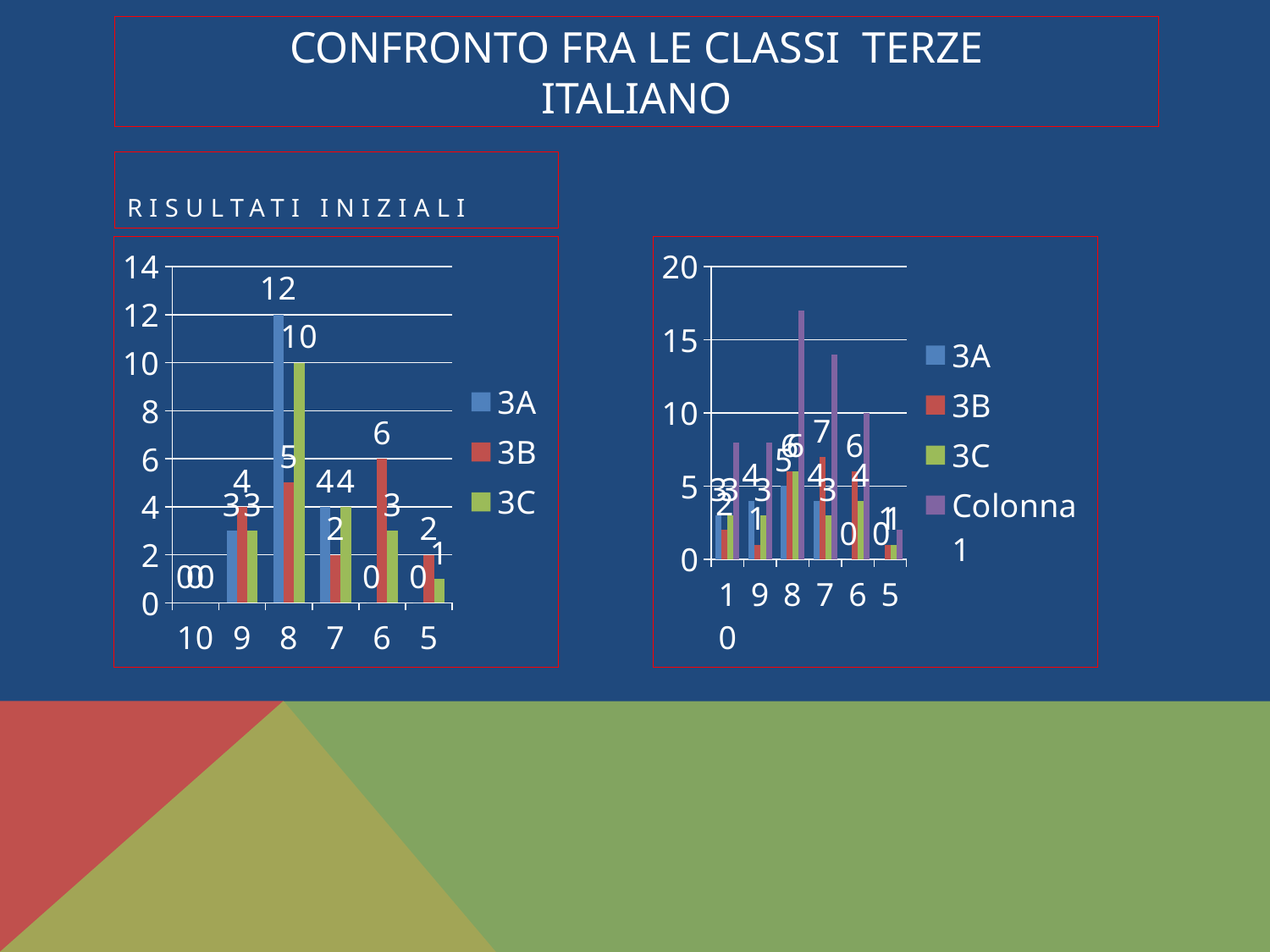
In the left chart (RISULTATI INIZIALI), how many categories are shown on the x axis? 6 In the left chart (RISULTATI INIZIALI), what is the value for 3C at category 8? 10 In the right chart, what is the fourth entry in the legend? Colonna 1 In the left chart (RISULTATI INIZIALI), at which category does 3A reach its highest value? 8 What kind of chart is the left chart (RISULTATI INIZIALI)? bar chart In the left chart (RISULTATI INIZIALI), what is the value for 3A at category 8? 12 In the left chart (RISULTATI INIZIALI), which is larger at category 6, 3B or 3C? 3B In the right chart, how many series does the legend list? 4 In the left chart (RISULTATI INIZIALI), how many series does the legend list? 3 In the left chart (RISULTATI INIZIALI), what is the difference between 3A and 3C at category 8? 2 In the right chart, is the value for Colonna 1 at category 8 greater or less than 15? greater In the left chart (RISULTATI INIZIALI), what is the value for 3B at category 6? 6